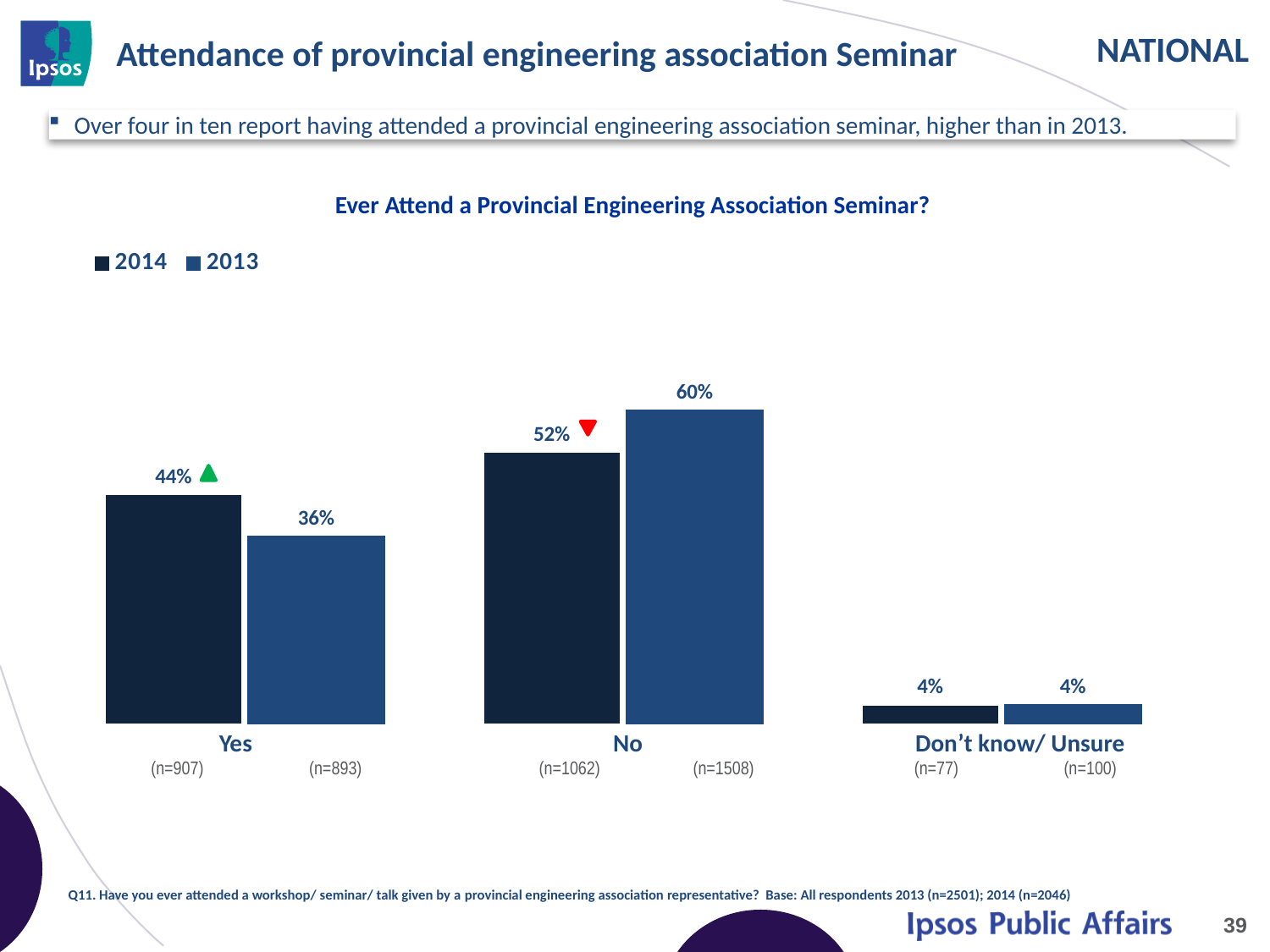
Which category has the lowest value for 2013? Don't know/ Unsure What kind of chart is shown on the slide? Bar chart What is the difference between the 2013 and 2014 values for No? 8 percentage points What is the difference between the 2014 and 2013 values for Yes? 8 percentage points What is the title of the chart? Ever Attend a Provincial Engineering Association Seminar? How many response categories are shown on the x axis? 3 What is the 2014 value for Don't know/ Unsure? 4% What percentage of respondents in 2013 said No? 60% What percentage of respondents in 2014 said Yes to ever attending a provincial engineering association seminar? 44% How many series does the legend list? 2 Which is larger, the 2014 value for Yes or the 2013 value for Yes? 2014 Which category has the highest value for 2014? No